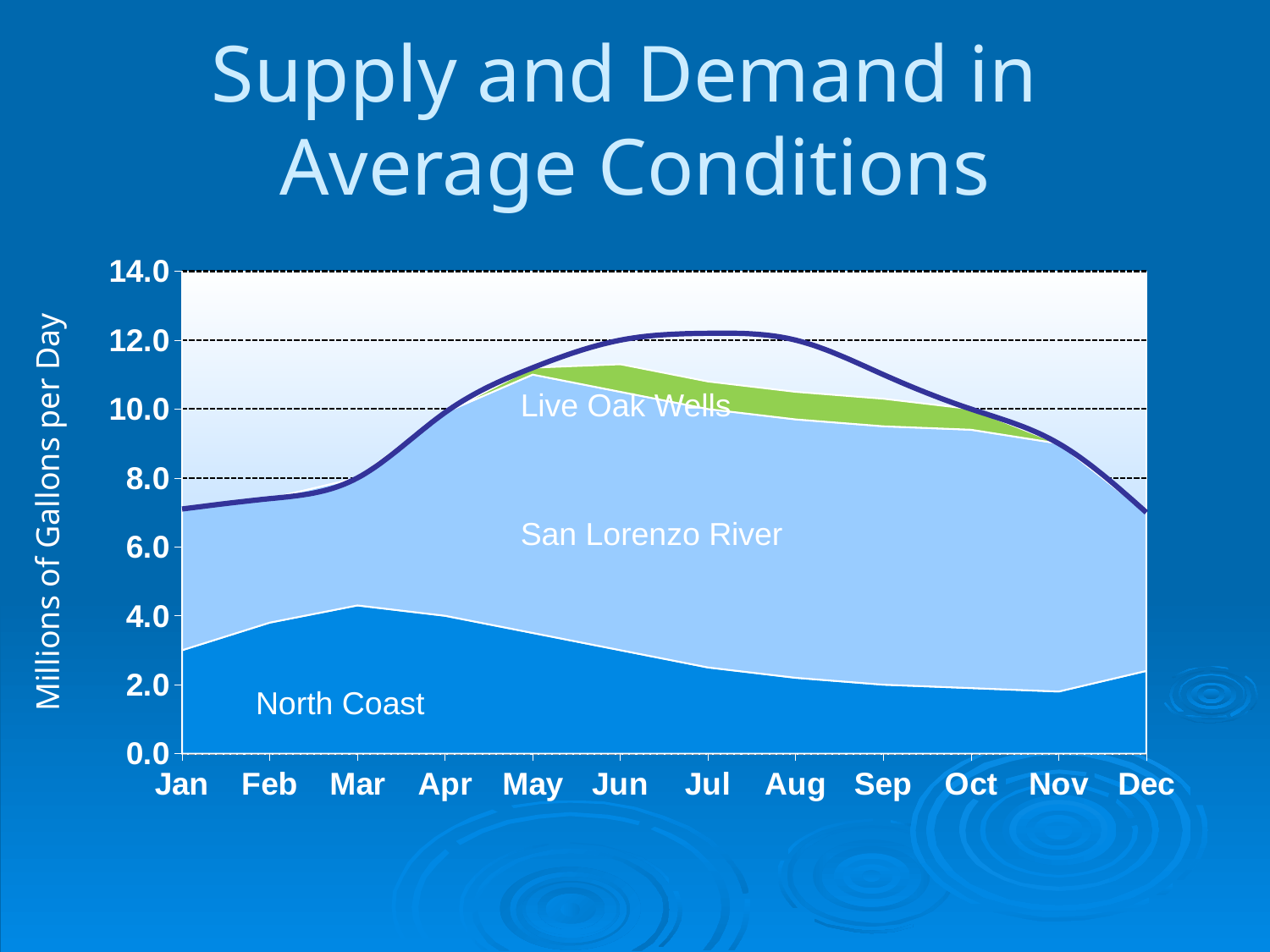
What kind of chart is shown on the slide? combination area and line chart Is the North Coast value for Jan greater or less than 4.0? less How many named supply sources are labelled as areas in the chart? 3 How many months are shown along the x axis of the chart? 12 What is the label on the y axis of the chart? Millions of Gallons per Day Is the total stacked supply for Jul greater or less than 12.0? less Is the demand line value for Dec greater or less than 8.0? less In which month does the demand line reach its highest value? Jul Which supply source is shown as the green area in the chart? Live Oak Wells Does the North Coast supply rise or fall from Mar to Nov? fall In which month does the North Coast supply reach its highest value? Mar